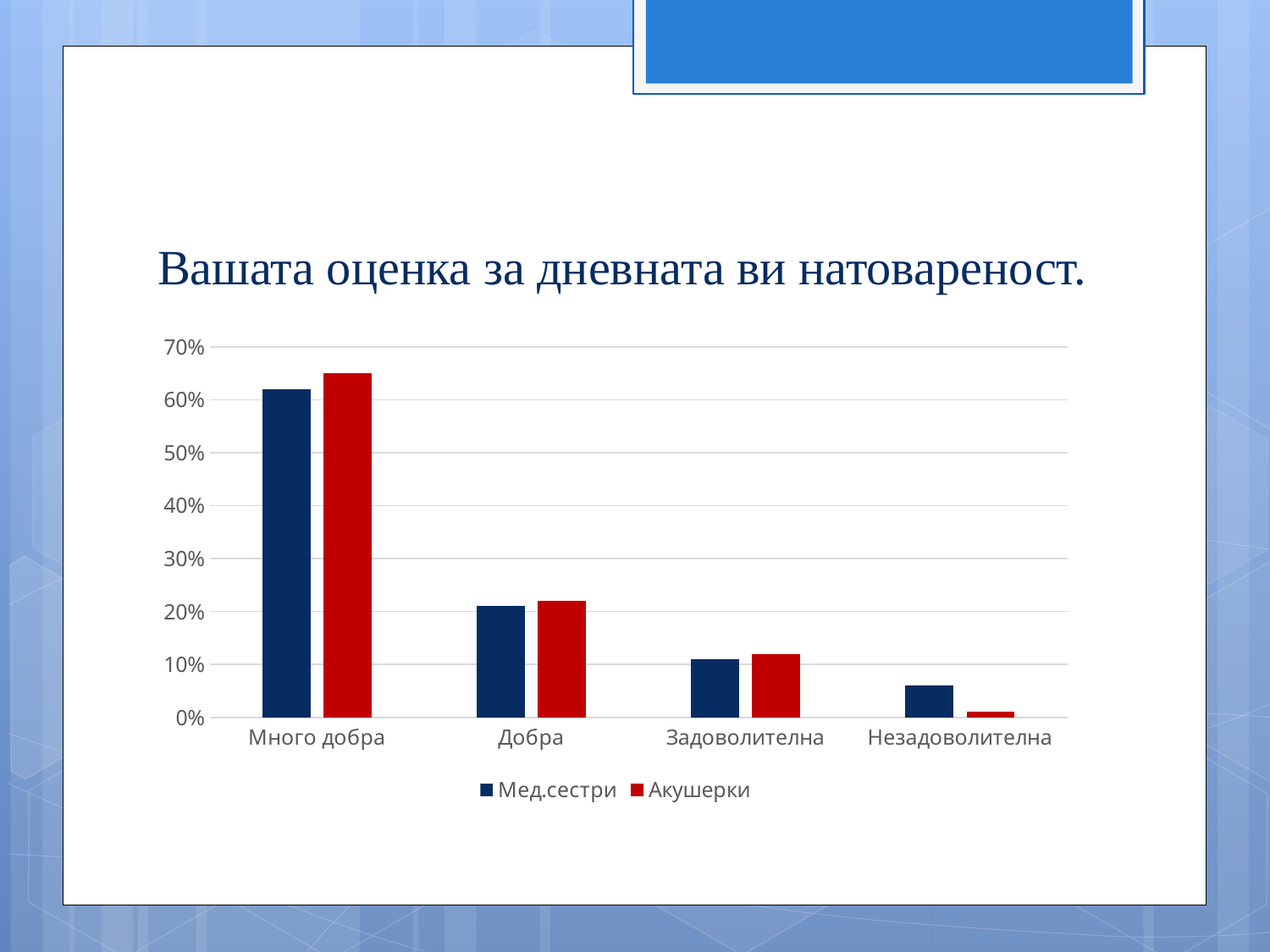
Do the values for Мед.сестри rise or fall from Много добра to Незадоволителна? fall For Много добра, which series has the larger value, Мед.сестри or Акушерки? Акушерки Which category has the lowest value for Акушерки? Незадоволителна How many series does the legend list? 2 What is the title of the chart? Вашата оценка за дневната ви натовареност. Is the value for Акушерки in Много добра greater or less than 60%? greater Which category has the highest value for Мед.сестри? Много добра For Незадоволителна, which series has the larger value, Мед.сестри or Акушерки? Мед.сестри How many categories are shown on the x axis? 4 Is the value for Мед.сестри in Добра greater or less than 30%? less Is the value for Акушерки in Незадоволителна greater or less than 10%? less What kind of chart is shown on the slide? bar chart